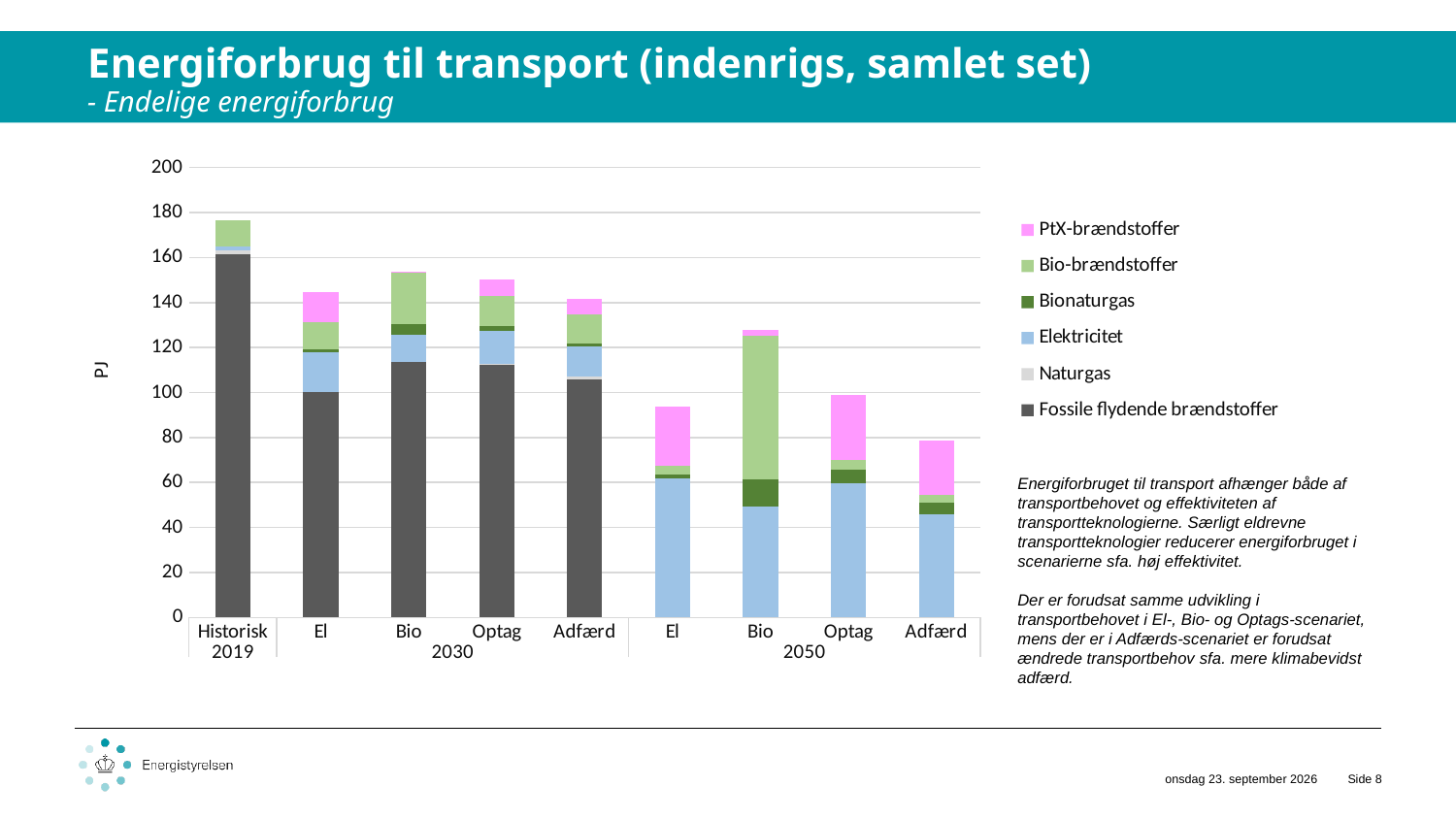
Is the total value for Bio in 2050 greater or less than 120? greater Which bar has the lowest total value? Adfærd 2050 How many bars (categories) are plotted in the chart? 9 Which has a larger total value: El in 2030 or El in 2050? El in 2030 Is the total value for Bio in 2030 greater or less than 140? greater How many series does the legend list? 6 What kind of chart is shown on the slide? Stacked bar chart Which has a larger total value in 2050: Bio or Optag? Bio Which bar has the highest total value? Historisk 2019 Is the total value for El in 2050 greater or less than 100? less What unit is shown on the y-axis of the chart? PJ